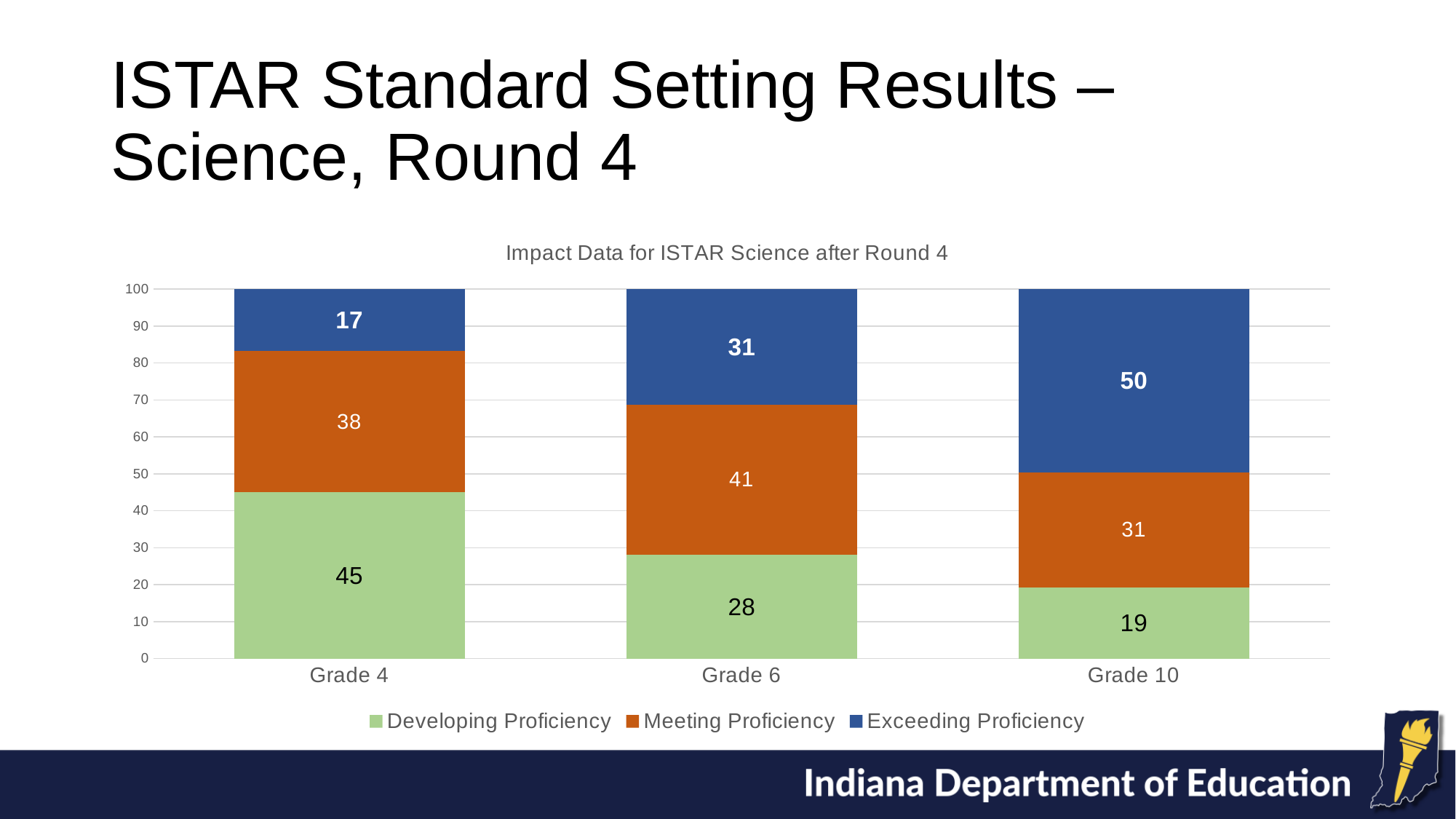
What is the Developing Proficiency value for Grade 4? 45 What is the title of the chart? Impact Data for ISTAR Science after Round 4 What is the total of the stacked bar for Grade 6? 100 What is the Meeting Proficiency value for Grade 6? 41 Which grade has the lowest Developing Proficiency value? Grade 10 Which is larger: the Meeting Proficiency value for Grade 4 or for Grade 10? Grade 4 What is the difference between the Exceeding Proficiency values for Grade 10 and Grade 4? 33 How many grades are shown on the x axis? 3 How many series does the legend list? 3 What kind of chart is shown on the slide? Stacked bar chart Which grade has the highest Exceeding Proficiency value? Grade 10 What is the Exceeding Proficiency value for Grade 10? 50